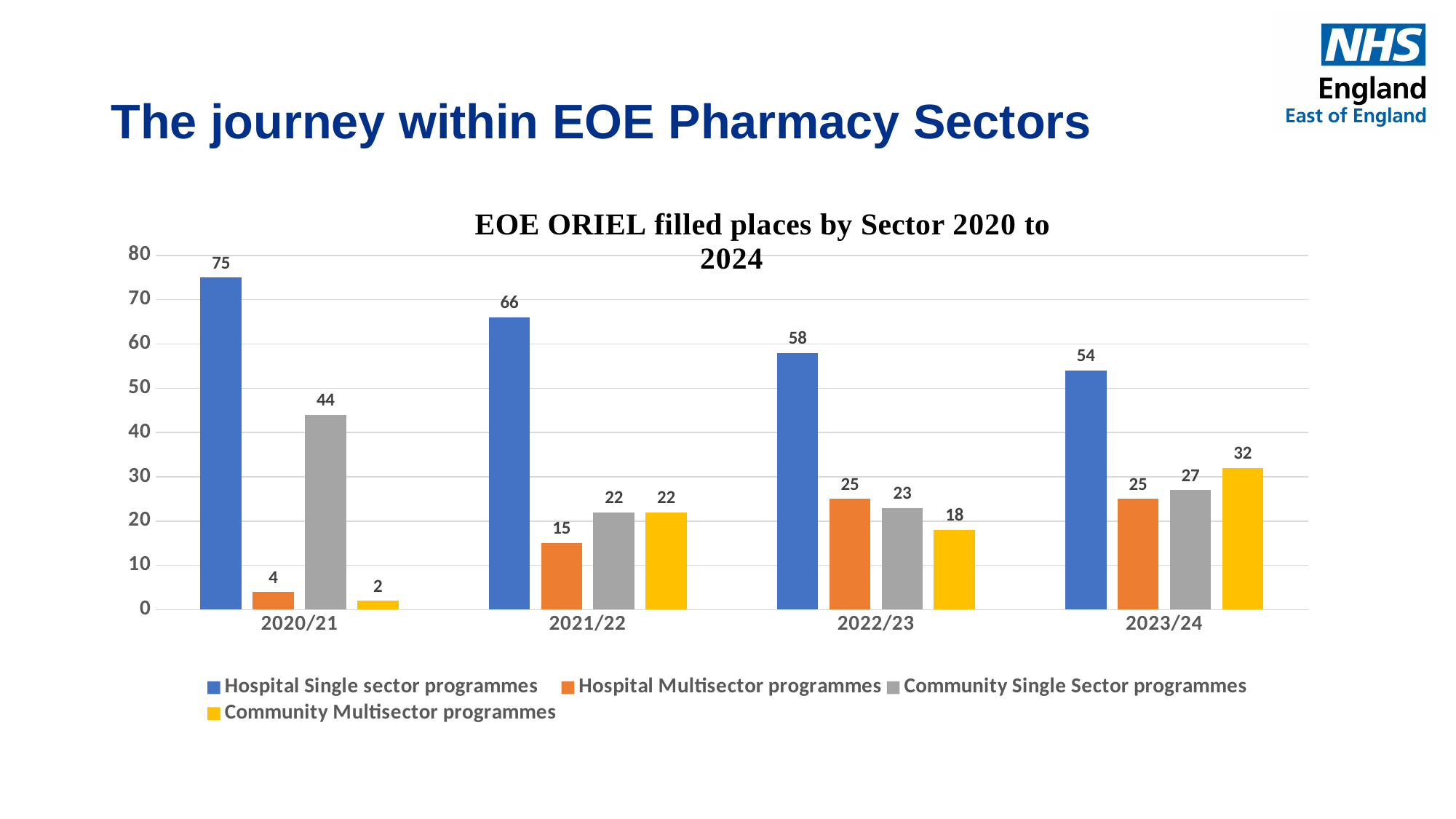
Do the values for Hospital Single sector programmes rise or fall from 2020/21 to 2023/24? Fall What is the difference between Hospital Single sector programmes in 2020/21 and 2023/24? 21 What is the title of the chart? EOE ORIEL filled places by Sector 2020 to 2024 Which year has the highest value for Hospital Single sector programmes? 2020/21 Which year has the lowest value for Community Multisector programmes? 2020/21 What is the value for Hospital Single sector programmes in 2020/21? 75 How many series does the legend list? 4 How many years are shown on the x axis? 4 Which is larger in 2023/24: Community Single Sector programmes or Community Multisector programmes? Community Multisector programmes What kind of chart is shown on the slide? Bar chart What is the value for Community Multisector programmes in 2023/24? 32 What is the value for Hospital Multisector programmes in 2021/22? 15